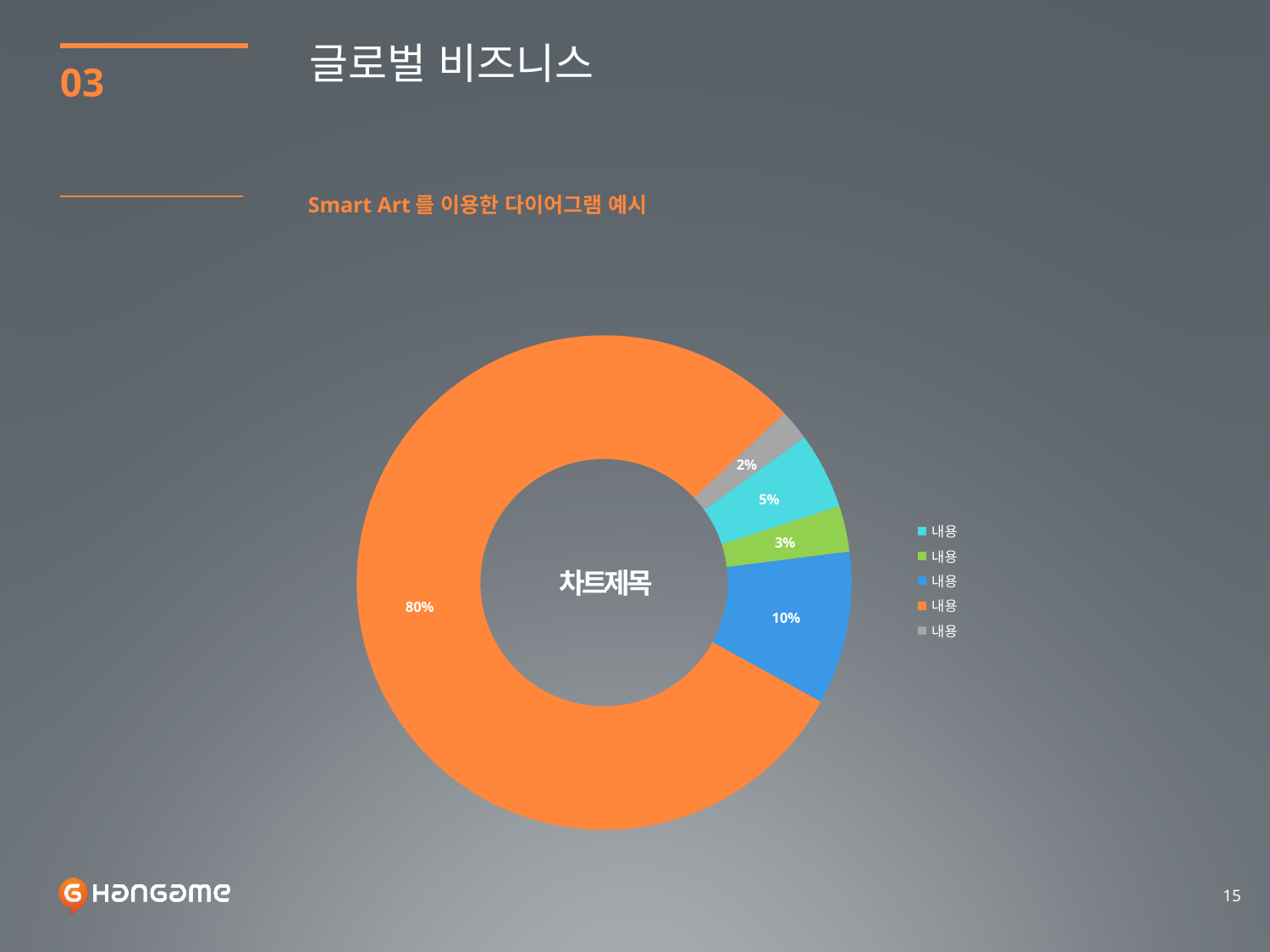
What is the difference between the orange slice and the blue slice? 70% What percentage is shown on the orange slice of the chart? 80% What percentage is shown on the cyan (light blue) slice of the chart? 5% How many entries does the chart's legend list? 5 Which slice of the chart is the largest? the orange slice (80%) How many slices does the doughnut chart have? 5 What kind of chart is shown on the slide? doughnut chart What percentage is shown on the green slice of the chart? 3% Which slice of the chart is the smallest? the gray slice (2%) What percentage is shown on the gray slice of the chart? 2% What is the title shown in the centre of the chart? 차트제목 What percentage is shown on the blue slice of the chart? 10%